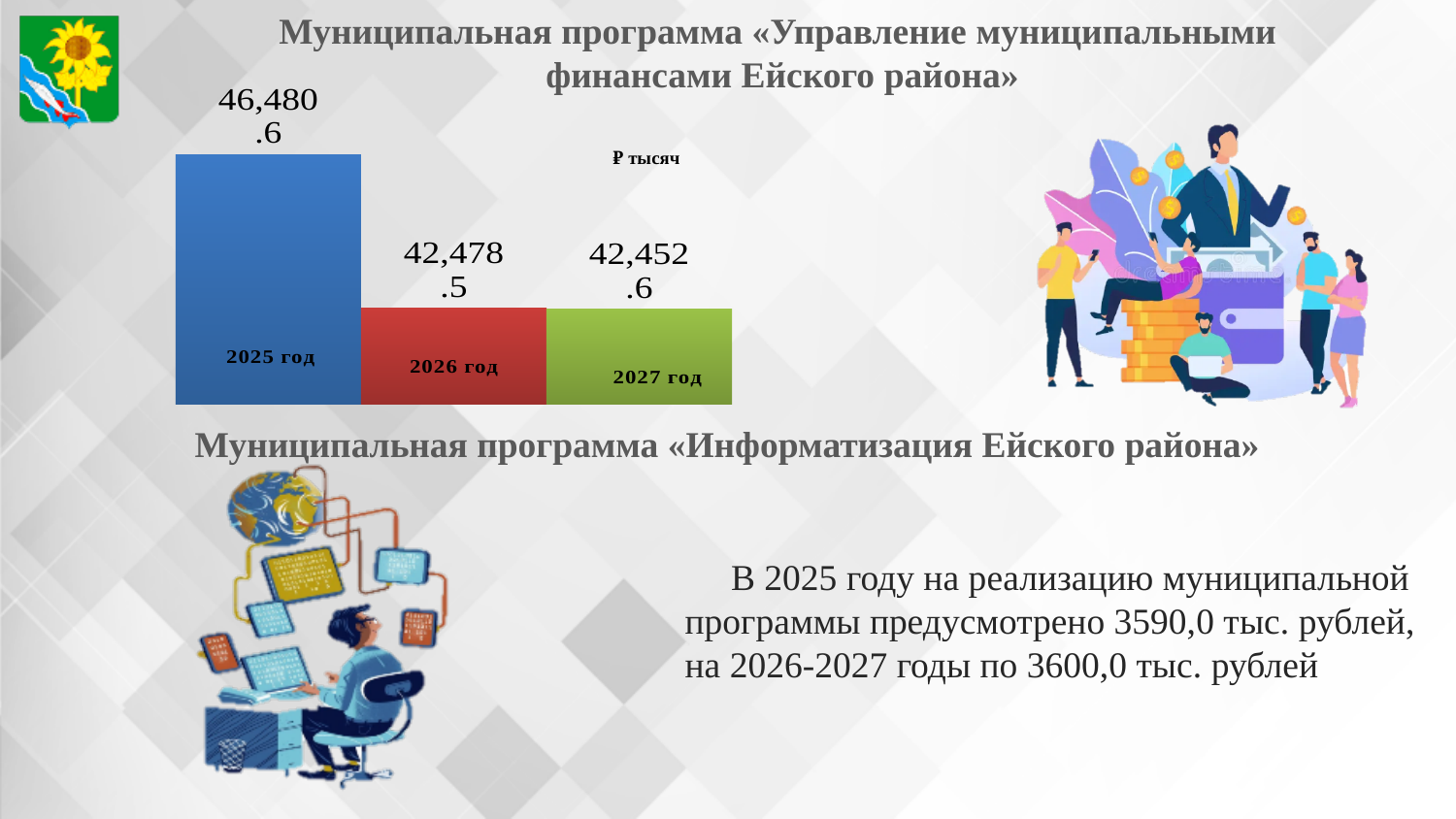
What is the difference between the values for 2025 год and 2026 год? 4,002.1 Which year has the highest value in the bar chart? 2025 год Do the values rise or fall from 2025 год to 2027 год? Fall What kind of chart is shown on the slide? Bar chart What unit is indicated for the values in the chart? ₽ тысяч How many bars are shown in the chart? 3 What is the value for 2027 год in the bar chart? 42,452.6 What is the value for 2025 год in the bar chart? 46,480.6 Which is larger, the value for 2026 год or the value for 2027 год? 2026 год What is the value for 2026 год in the bar chart? 42,478.5 Which year has the lowest value in the bar chart? 2027 год What is the difference between the values for 2026 год and 2027 год? 25.9